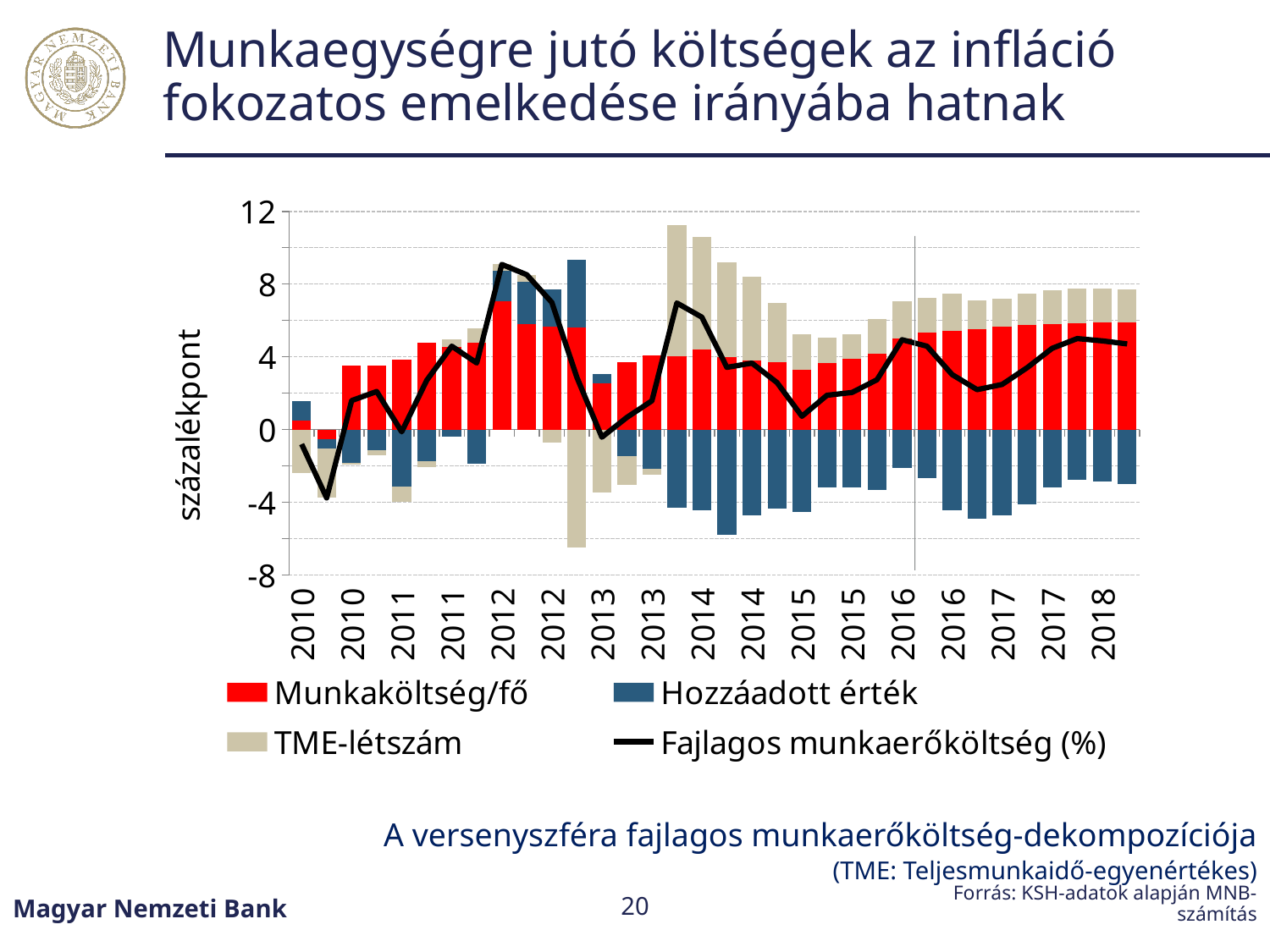
Which series' bar segment reaches the highest point on the chart? TME-létszám How many year labels are shown along the x axis? 17 Is the top of the tallest stacked bar on the chart greater or less than 8? greater How many series does the chart legend list? 4 Is the highest point of the Fajlagos munkaerőköltség (%) line greater or less than 8? greater Is the lowest point reached by any bar on the chart greater or less than -4? less What kind of chart is used to show the Munkaköltség/fő, Hozzáadott érték and TME-létszám series? bar chart Which series is drawn as a line rather than as bars? Fajlagos munkaerőköltség (%) Does the Fajlagos munkaerőköltség (%) line rise or fall between the first 2010 point and the first 2012 point? rise What is the label on the vertical axis of the chart? százalékpont Does the Fajlagos munkaerőköltség (%) line rise or fall between the first 2012 point and the first 2013 point? fall